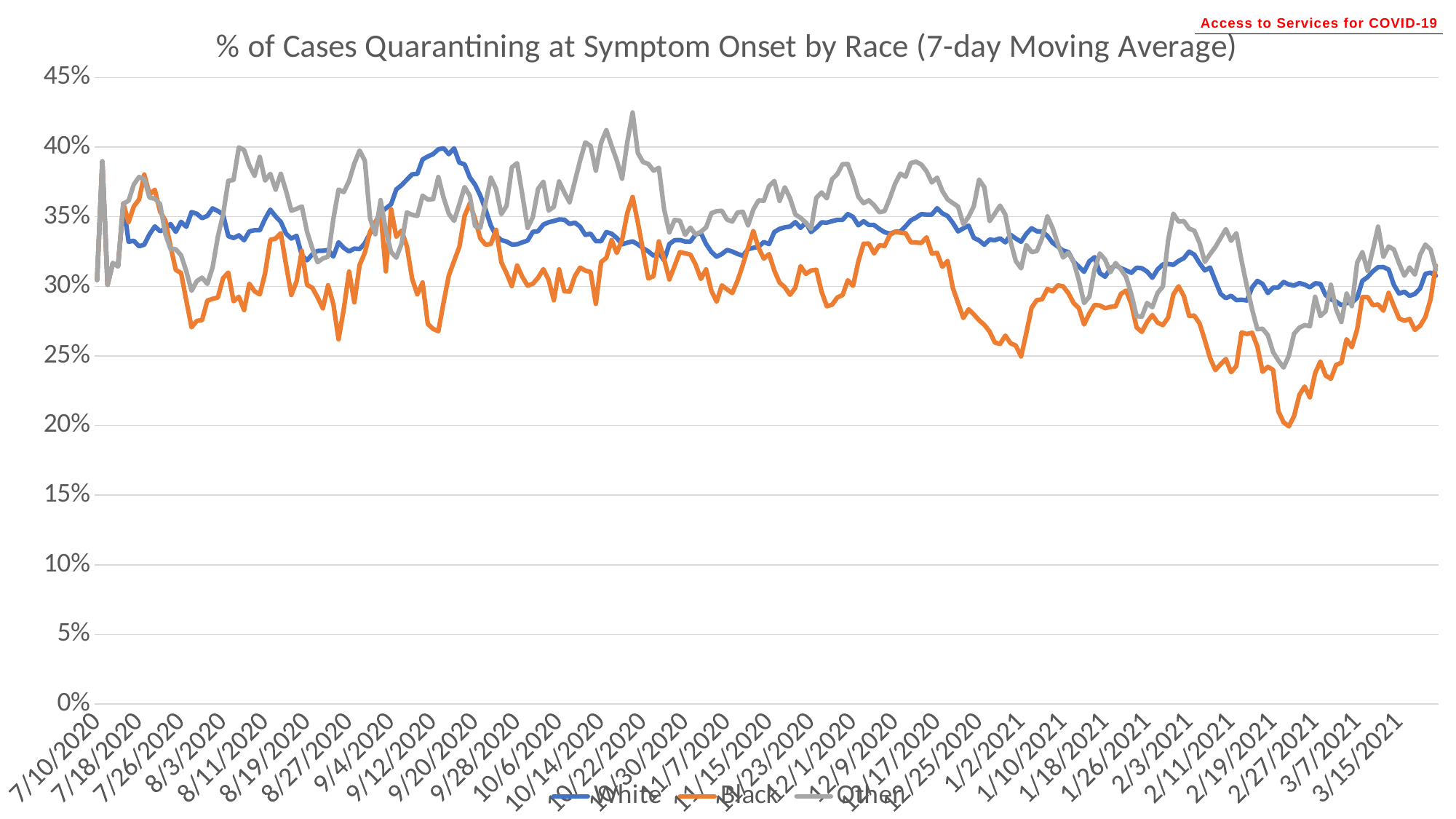
Which series reaches the highest value anywhere on the chart? Other Around 10/22/2020, which series has the larger value, Other or Black? Other What is the title of the chart? % of Cases Quarantining at Symptom Onset by Race (7-day Moving Average) Which colour is used for the Black series? orange Which series reaches the lowest value anywhere on the chart? Black Is the value for the Black series around 2/19/2021 greater or less than 25%? less How many series does the legend list? 3 Around 2/19/2021, which series has the larger value, White or Black? White Does the Black series overall rise or fall from 7/10/2020 to 3/15/2021? fall Is the peak value for the Other series around 10/22/2020 greater or less than 40%? greater What kind of chart is shown on the slide? line chart Is the value for the White series around 9/12/2020 greater or less than 35%? greater